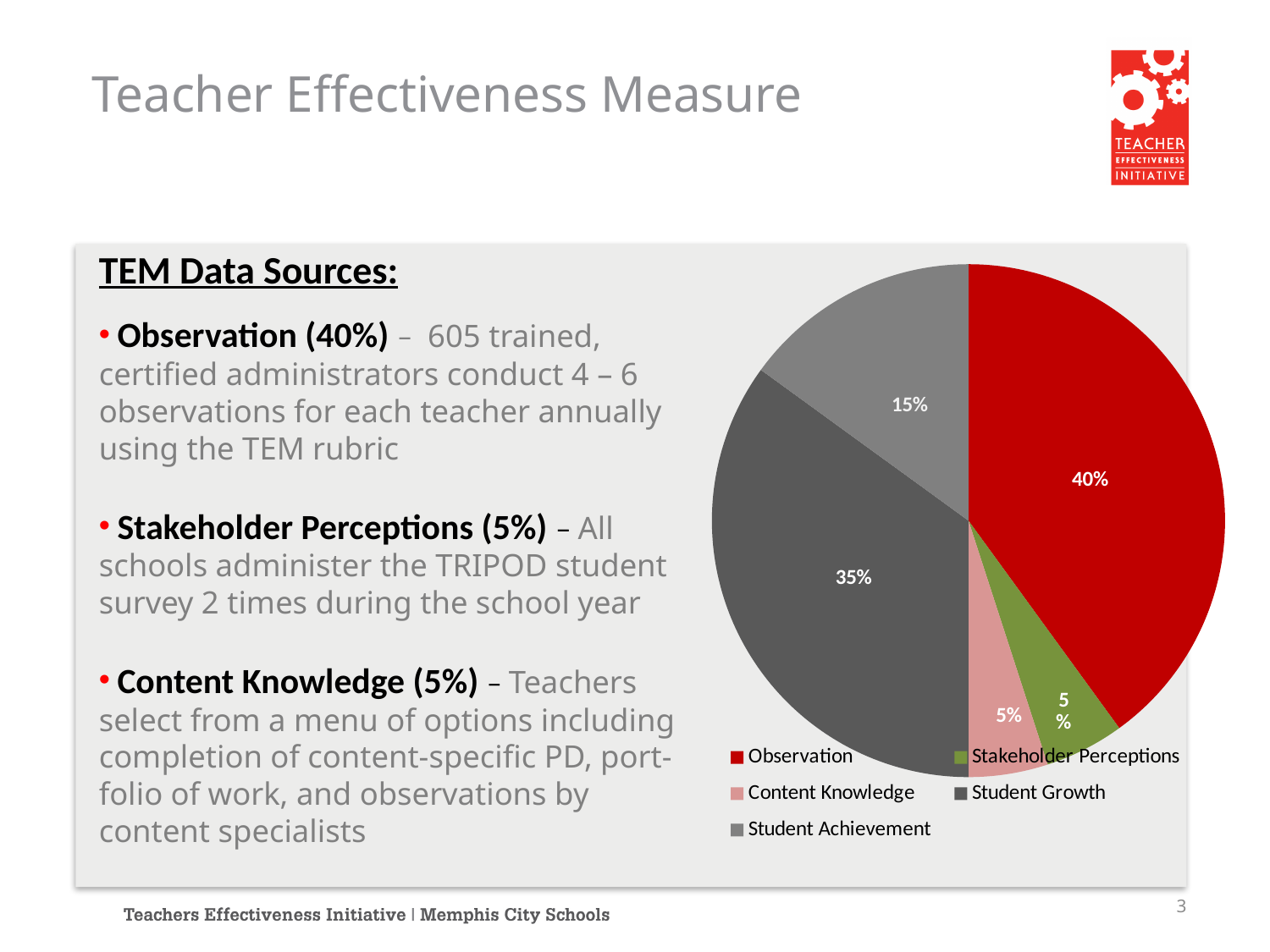
What share of the pie does Observation represent? 40% What share of the pie does Student Achievement represent? 15% Which legend entry is shown in green? Stakeholder Perceptions What type of chart is shown on the slide? Pie chart What share of the pie does Student Growth represent? 35% Which category has the largest slice of the pie? Observation How many entries does the legend list? 5 What is the difference between the Student Achievement share and the Content Knowledge share? 10% What is the difference between the Observation share and the Student Growth share? 5% Which is larger, the Student Growth slice or the Student Achievement slice? Student Growth How many slices does the pie chart have? 5